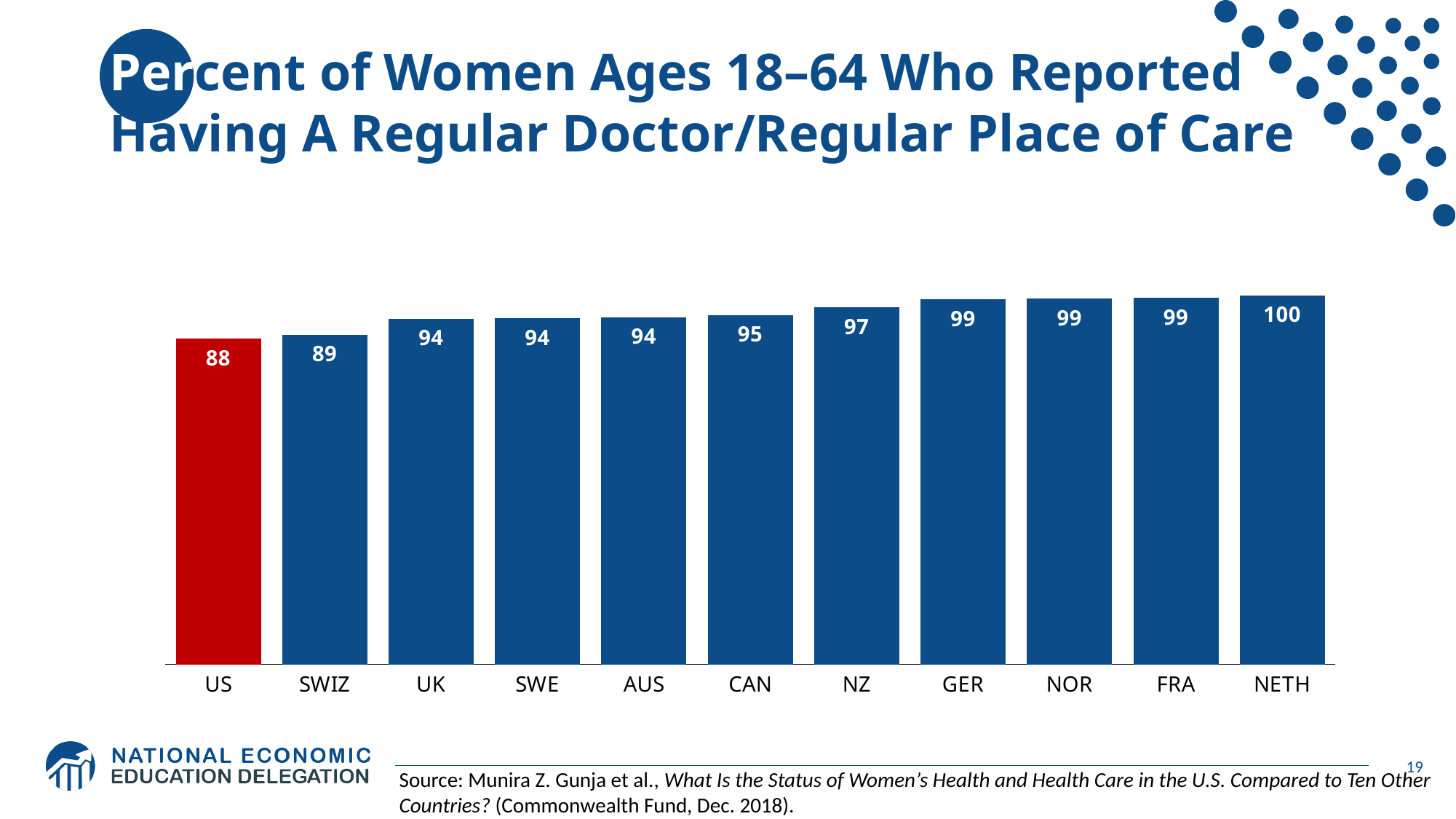
Which bar is coloured red rather than blue? US What is the difference between the values for SWIZ and the US? 1 What is the difference between the values for NETH and the US? 12 Which has a larger value, UK or NZ? NZ What kind of chart is this? bar chart What is the value for CAN? 95 How many countries are shown on the chart? 11 Do the values rise or fall from left to right along the x axis? rise What is the value for the US? 88 Which country has the highest value? NETH What is the value for NZ? 97 Which country has the lowest value? US